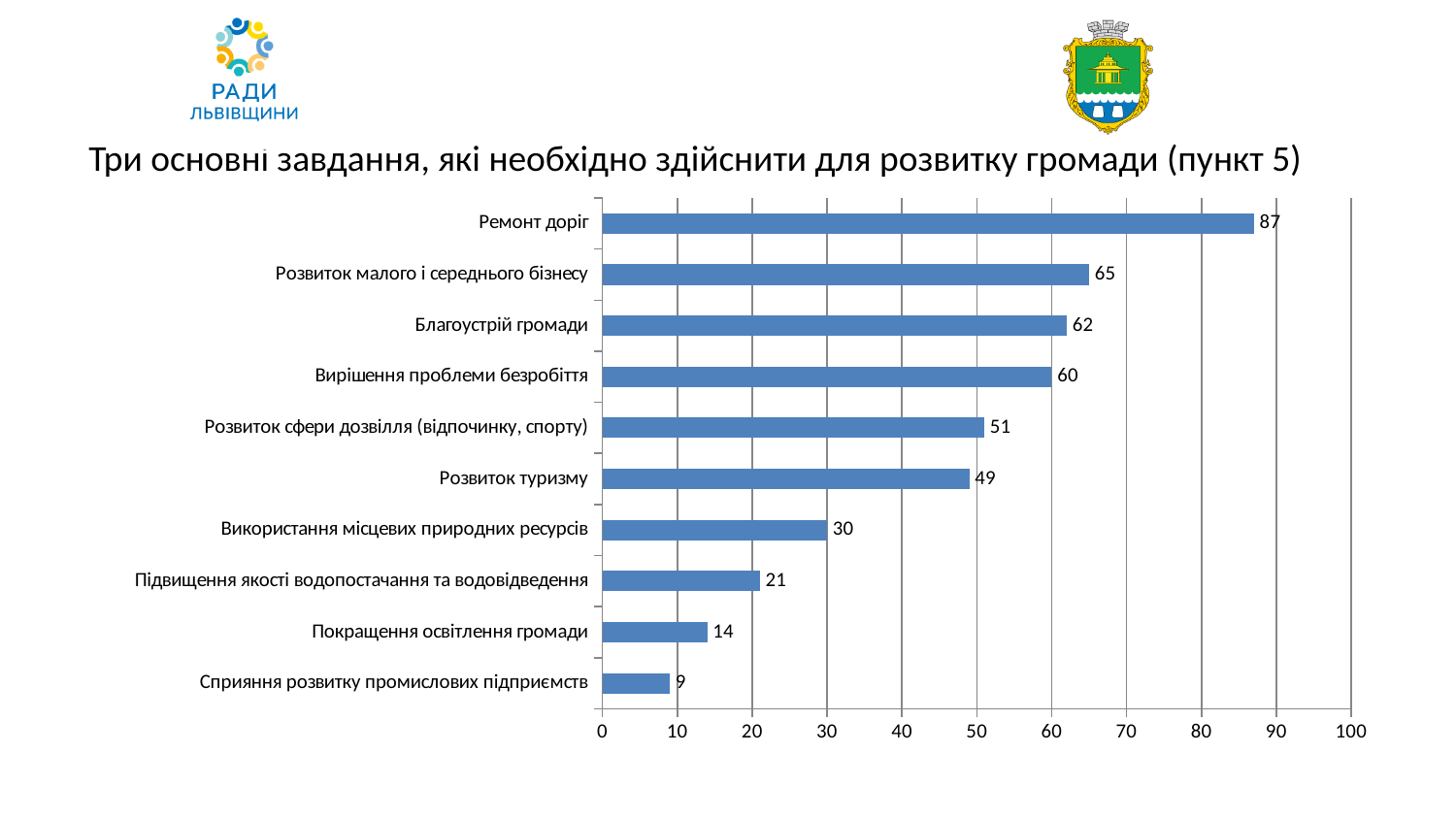
What is the difference between the values for Покращення освітлення громади and Сприяння розвитку промислових підприємств? 5 What is the value for Підвищення якості водопостачання та водовідведення? 21 Which category has the highest value? Ремонт доріг Which category has the lowest value? Сприяння розвитку промислових підприємств What is the value for Розвиток туризму? 49 What is the maximum value shown on the horizontal axis? 100 What is the value for Ремонт доріг? 87 What is the difference between the values for Ремонт доріг and Розвиток малого і середнього бізнесу? 22 Which is larger: the value for Благоустрій громади or the value for Вирішення проблеми безробіття? Благоустрій громади What kind of chart is shown on the slide? bar chart How many categories are shown in the chart? 10 Is the value for Використання місцевих природних ресурсів greater or less than 40? less